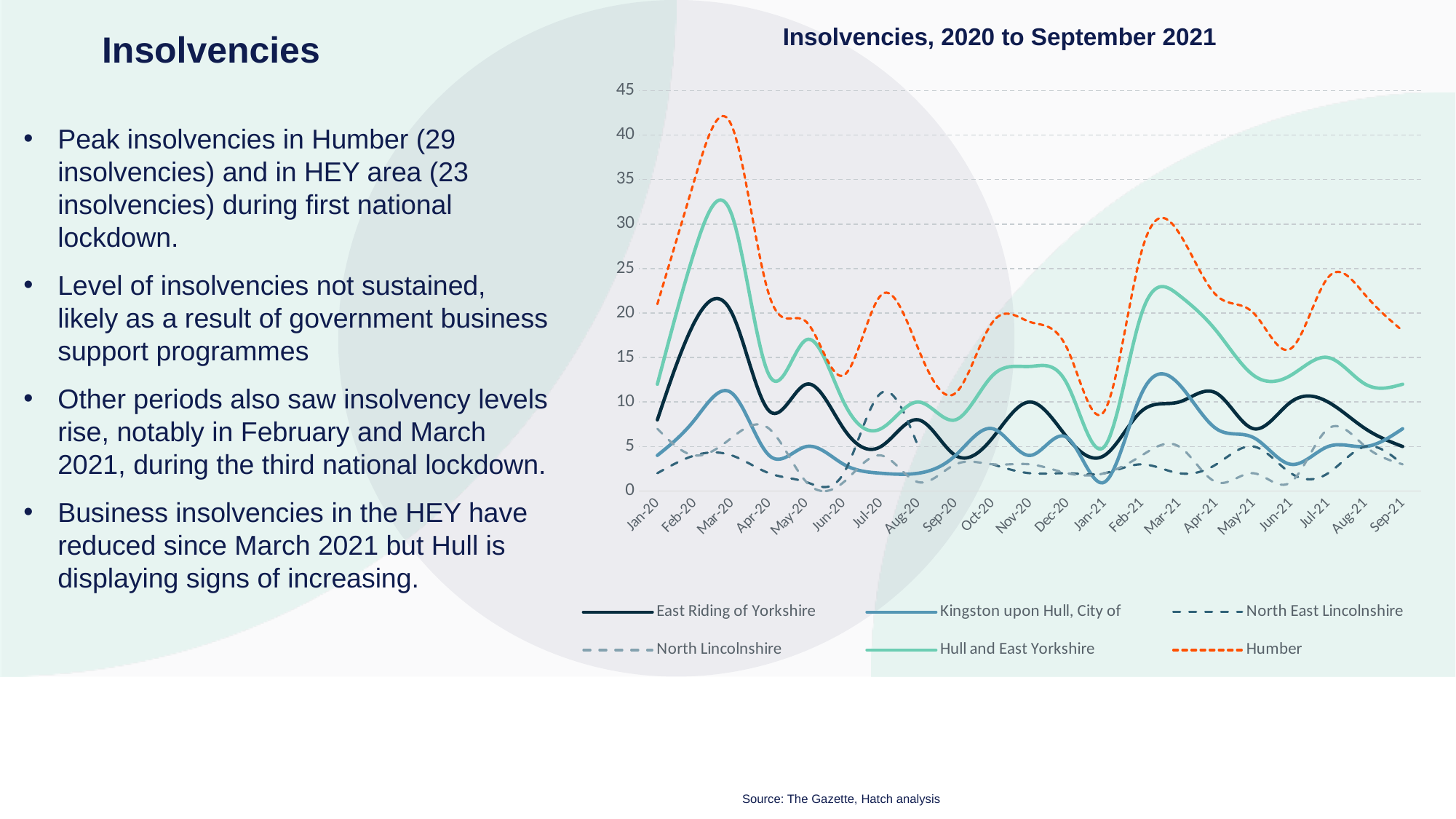
In Mar-20, which is larger: Humber or Hull and East Yorkshire? Humber Which series reaches the highest value on the chart? Humber What is the title of the chart? Insolvencies, 2020 to September 2021 Is the value for Humber in Mar-21 greater or less than 25? greater Is the value for Hull and East Yorkshire in Mar-20 greater or less than 30? greater In which month does the Humber series reach its peak? Mar-20 What kind of chart is shown on the slide? line chart Is the value for Humber in Mar-20 greater or less than 40? greater How many series does the chart legend list? 6 How many months are plotted along the x axis of the chart? 21 Which series is drawn as an orange dashed line? Humber